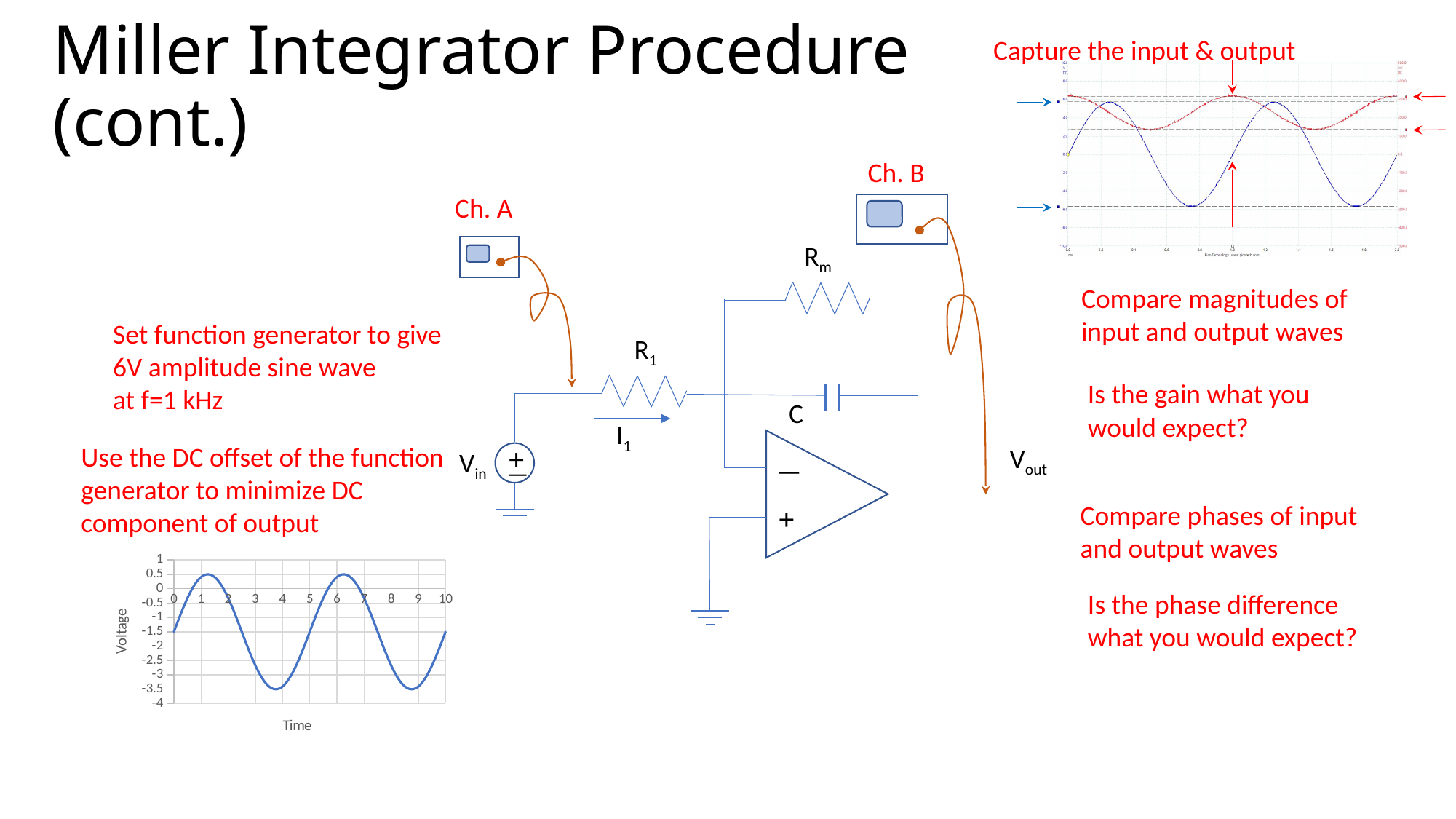
In the bottom-left chart, is the voltage at time 1 greater or less than 0? greater In the bottom-left chart, does the voltage rise or fall between time 2 and time 3? fall In the bottom-left chart, what is the label on the horizontal axis? Time In the bottom-left chart, what is the difference between the peak voltage and the trough voltage of the wave? 4 In the bottom-left chart, what is the highest voltage value the wave reaches? 0.5 What kind of chart is shown at the bottom left of the slide? line chart In the bottom-left chart, what is the lowest voltage value the wave reaches? -3.5 In the bottom-left chart, does the voltage rise or fall between time 0 and time 1? rise In the bottom-left chart, is the voltage at time 4 greater or less than -2? less In the bottom-left chart, which is larger: the voltage at time 1 or the voltage at time 4? time 1 In the bottom-left chart, what is the label on the vertical axis? Voltage In the bottom-left chart, how many tick marks are labelled on the Time axis? 11